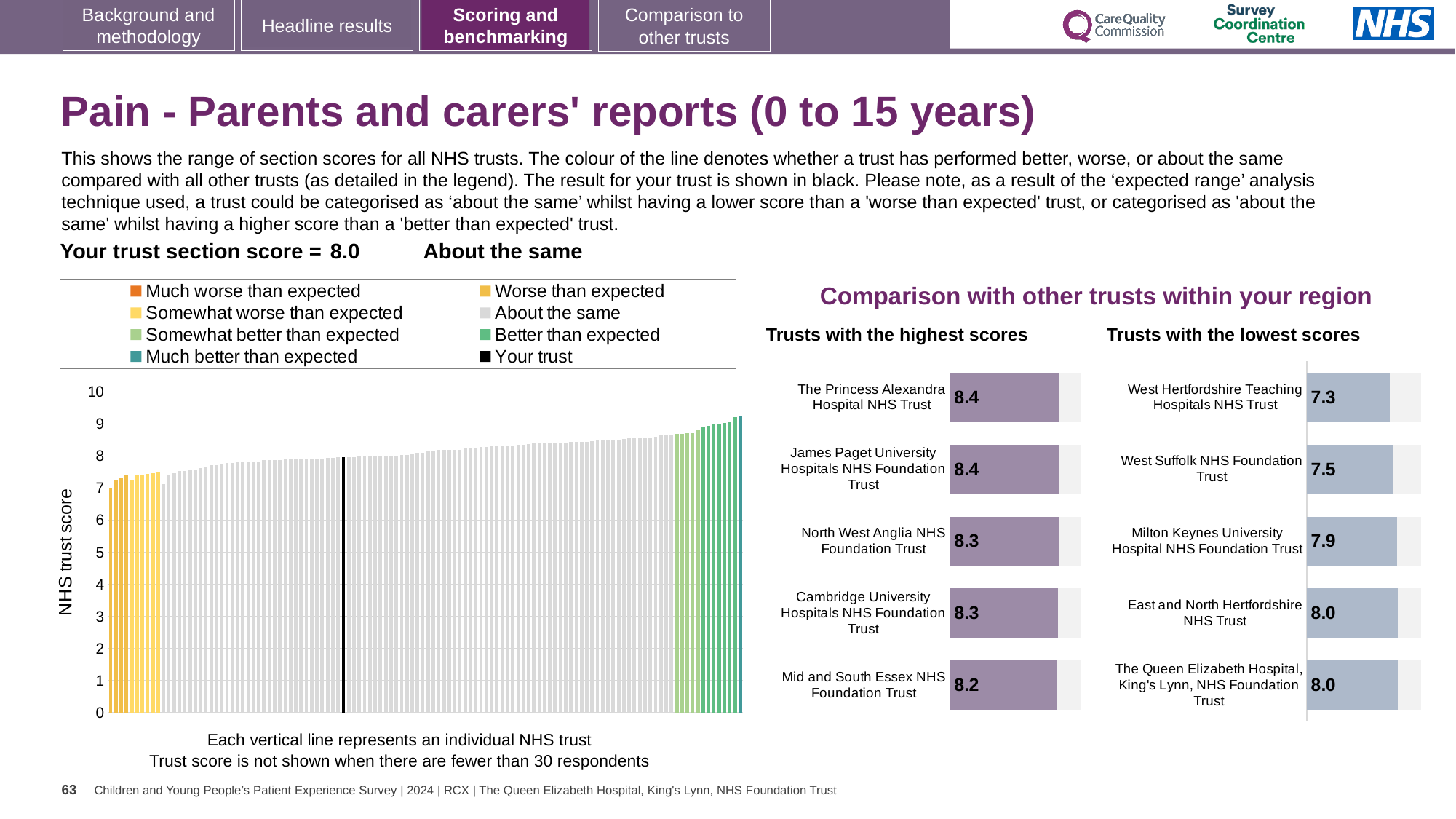
In the 'Trusts with the lowest scores' chart, what is the score for West Suffolk NHS Foundation Trust? 7.5 In the 'Trusts with the lowest scores' chart, what is the difference between the scores of Milton Keynes University Hospital NHS Foundation Trust and West Hertfordshire Teaching Hospitals NHS Trust? 0.6 In the main 'NHS trust score' chart on the left, do the bar values rise or fall from left to right? Rise In the 'Trusts with the lowest scores' chart, which has the higher score: West Suffolk NHS Foundation Trust or Milton Keynes University Hospital NHS Foundation Trust? Milton Keynes University Hospital NHS Foundation Trust How many trusts are listed in the 'Trusts with the highest scores' chart? 5 How many entries does the legend above the main 'NHS trust score' chart list? 8 What kind of chart is the main 'NHS trust score' chart on the left? Bar chart In the 'Trusts with the highest scores' chart, what is the score for North West Anglia NHS Foundation Trust? 8.3 In the 'Trusts with the highest scores' chart, which trust has the lowest score? Mid and South Essex NHS Foundation Trust In the main 'NHS trust score' chart on the left, is the value of the black bar representing your trust greater or less than 5? greater In the 'Trusts with the highest scores' chart, what is the difference between the scores of The Princess Alexandra Hospital NHS Trust and Mid and South Essex NHS Foundation Trust? 0.2 In the 'Trusts with the lowest scores' chart, which trust has the lowest score? West Hertfordshire Teaching Hospitals NHS Trust